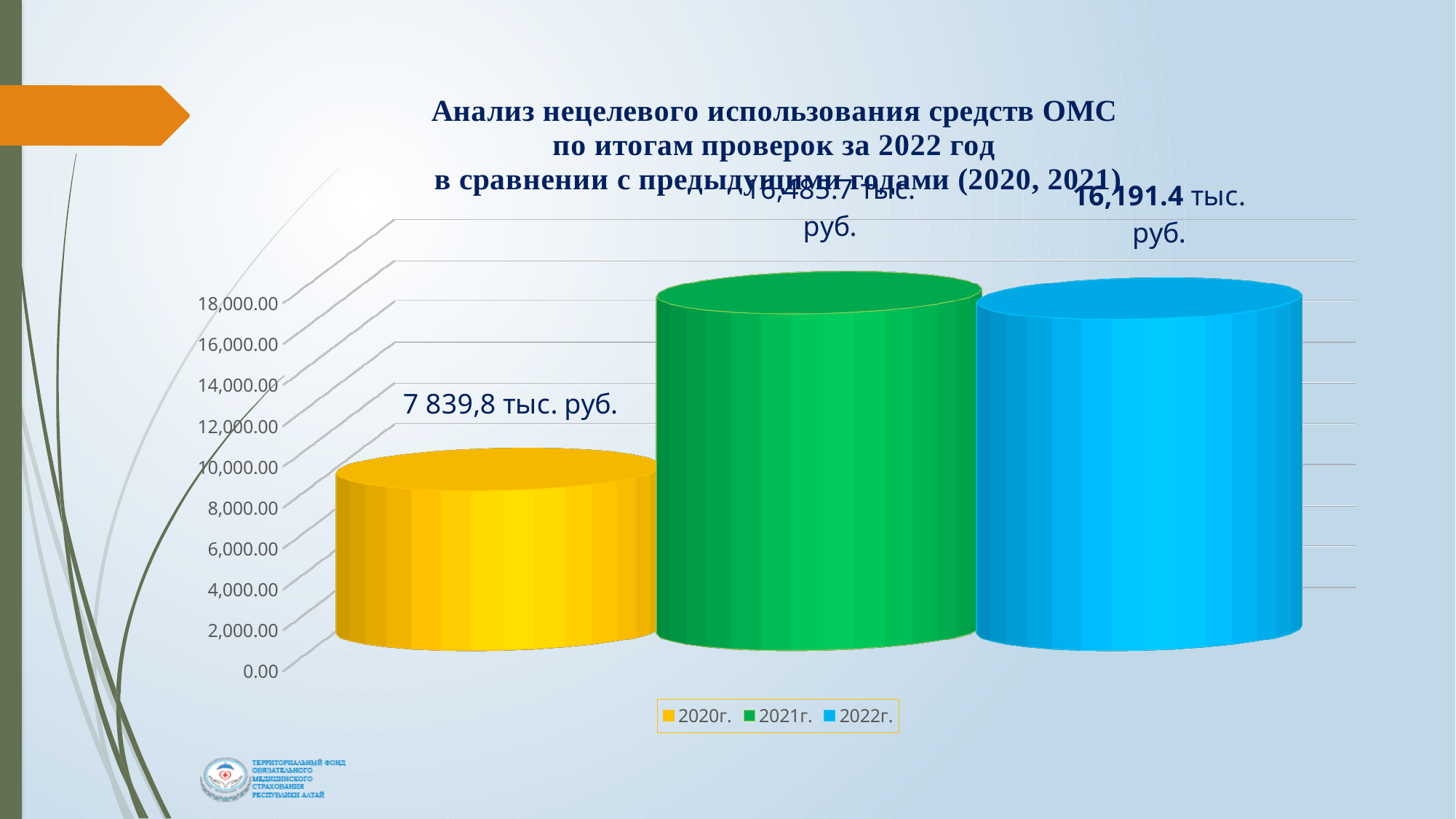
Which year has the lowest value? 2020г. How many entries does the legend list? 3 What value is shown for 2022г.? 16,191.4 тыс. руб. What colour is the bar for 2021г.? green What is the difference between the values for 2022г. and 2020г.? 8,351.6 тыс. руб. How many bars are plotted on the chart? 3 Which is larger, the value for 2020г. or the value for 2022г.? 2022г. Is the value for 2021г. greater or less than 14,000.00? greater What kind of chart is shown on the slide? bar chart Is the value for 2020г. greater or less than 10,000.00? less Is the value for 2022г. greater or less than 14,000.00? greater What value is shown for 2020г.? 7 839,8 тыс. руб.